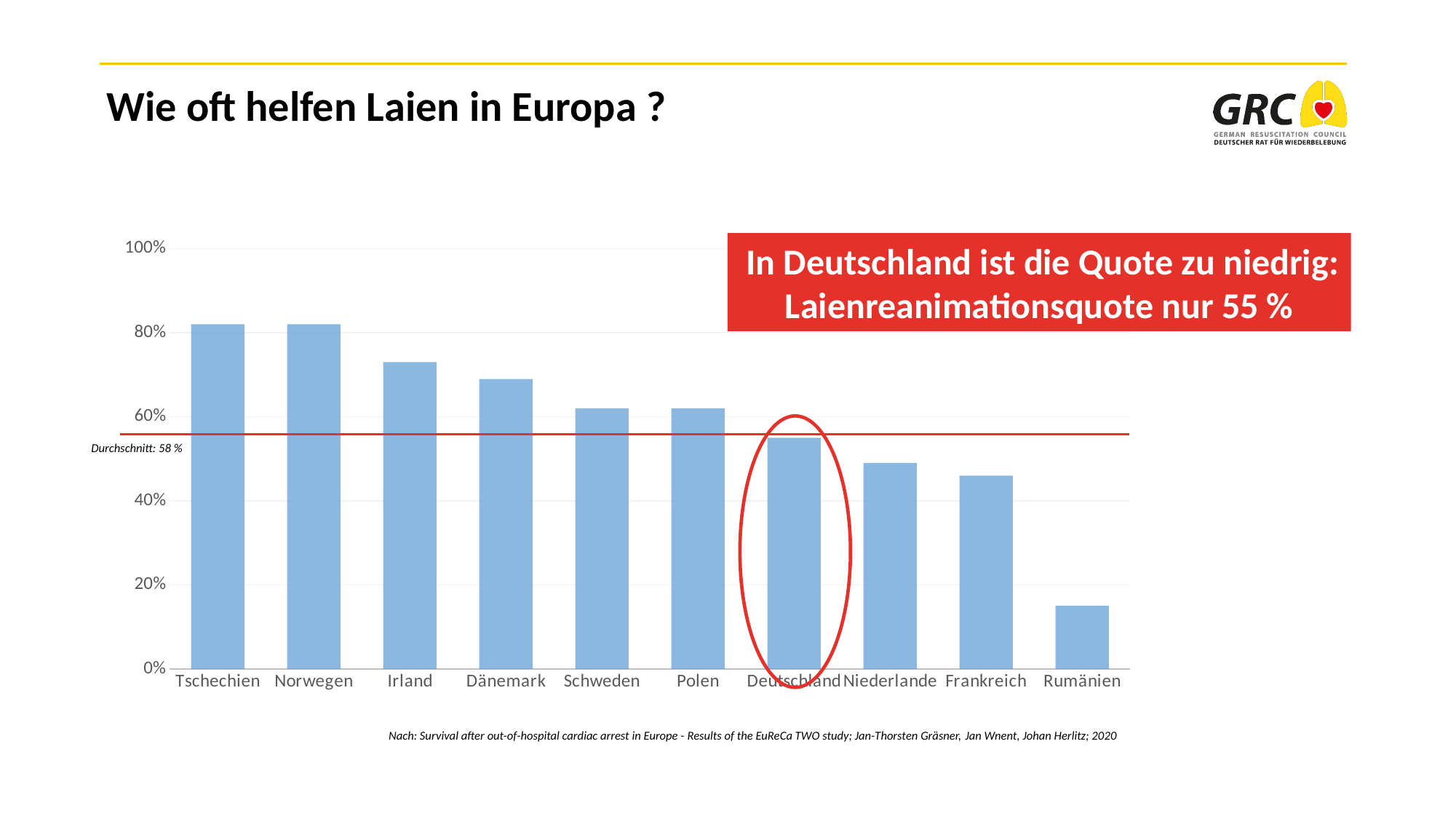
Is the value for Irland greater or less than 60%? greater Which country's bar is circled in red on the chart? Deutschland Which has the higher value, Irland or Frankreich? Irland Is the value for Frankreich greater or less than 60%? less According to the slide, what is the Laienreanimationsquote for Deutschland? 55 % What kind of chart is shown on the slide? bar chart What value does the horizontal red line labelled Durchschnitt mark? 58 % How many countries are shown on the x axis of the chart? 10 Do the bar values generally rise or fall from left to right along the x axis? fall Is the value for Rumänien greater or less than 20%? less Which country has the lowest bar in the chart? Rumänien